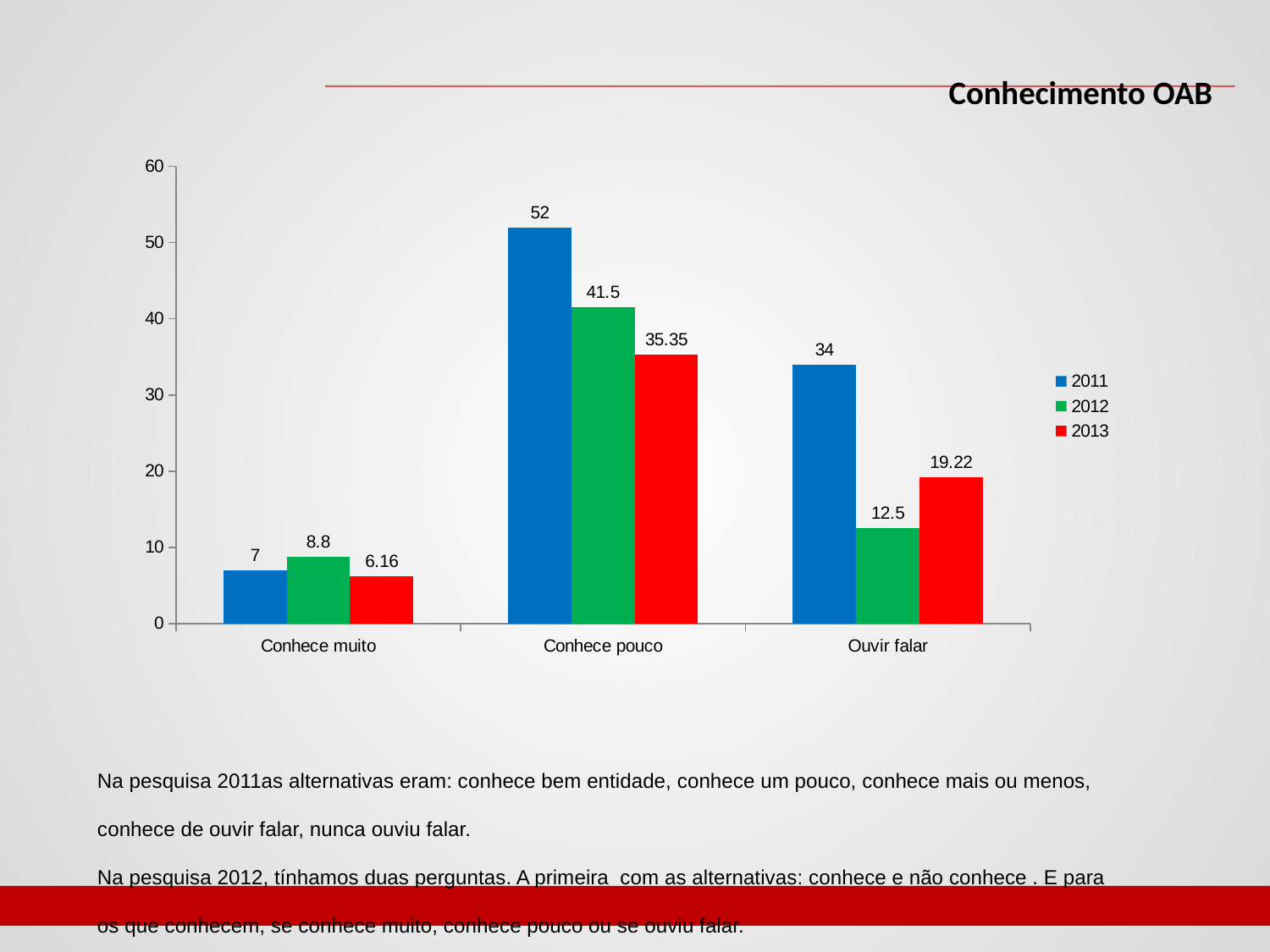
Which category has the highest value for 2011? Conhece pouco Which category has the lowest value for 2013? Conhece muito What is the value for 2013 in the Ouvir falar category? 19.22 What is the value for 2011 in the Conhece pouco category? 52 How many categories are shown on the x axis? 3 What is the value for 2012 in the Conhece muito category? 8.8 What is the difference between the 2011 and 2012 values for Conhece pouco? 10.5 Which colour represents the 2012 series in the legend? Green What kind of chart is shown on the slide? Bar chart Is the value for 2013 in Conhece pouco greater or less than 30? greater Which is larger in the Ouvir falar category, the 2012 value or the 2013 value? 2013 How many series does the legend list? 3